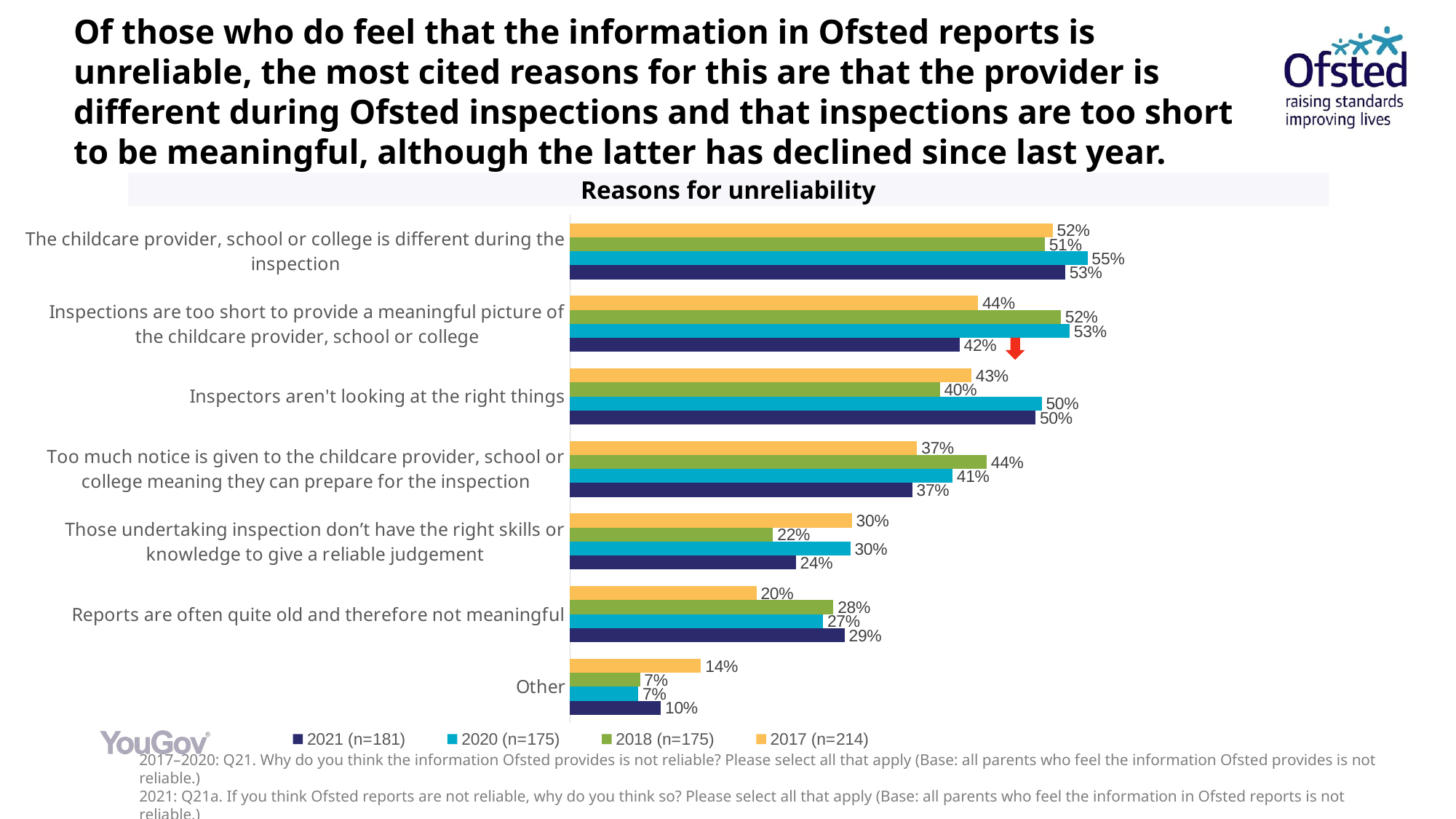
Which reason has the highest 2021 value? The childcare provider, school or college is different during the inspection What is the 2017 value for 'Reports are often quite old and therefore not meaningful'? 20% What is the 2018 value for 'Those undertaking inspection don't have the right skills or knowledge to give a reliable judgement'? 22% What is the difference between the 2020 and 2021 values for 'Inspections are too short to provide a meaningful picture of the childcare provider, school or college'? 11 percentage points For 'Too much notice is given to the childcare provider, school or college meaning they can prepare for the inspection', which year has the larger value: 2018 or 2020? 2018 What is the 2021 value for 'Inspections are too short to provide a meaningful picture of the childcare provider, school or college'? 42% What type of chart is shown on the slide? Bar chart What is the 2020 value for 'The childcare provider, school or college is different during the inspection'? 55% What is the title of the chart? Reasons for unreliability How many reasons (categories) are shown in the chart? 7 How many series does the legend list? 4 Which reason has the lowest 2017 value? Other